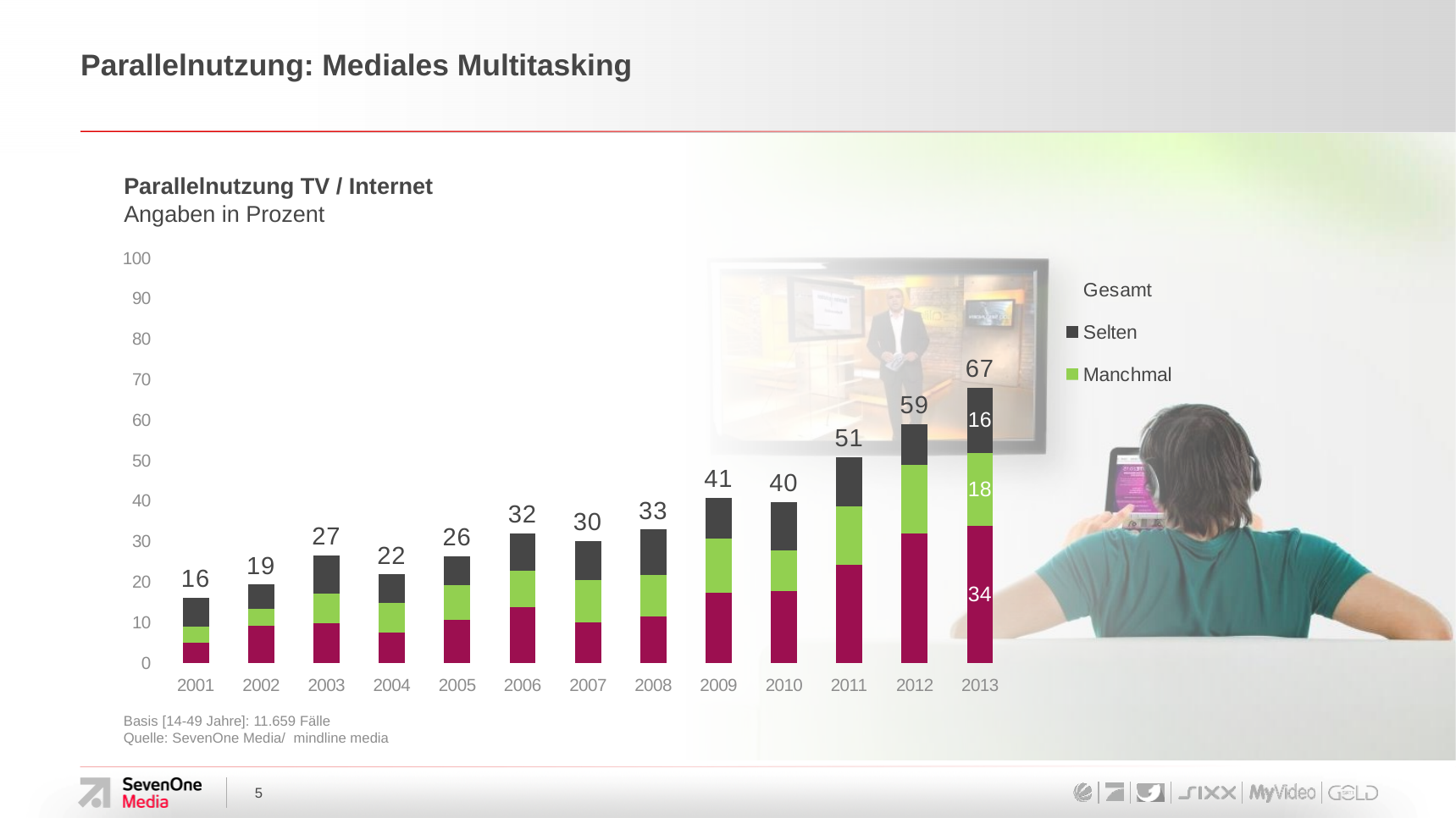
What is the value of the Manchmal segment in 2013? 18 What is the total value shown for 2001? 16 Do the total values generally rise or fall from 2001 to 2013? Rise Which year has the lowest total value? 2001 Which year has the highest total value? 2013 How many years are shown on the x axis? 13 What is the value of the Selten segment in 2013? 16 What is the total value shown for 2013? 67 What is the difference between the totals for 2013 and 2012? 8 Which year has the larger total, 2009 or 2010? 2009 Which year has the larger total, 2003 or 2004? 2003 What kind of chart is shown on the slide? Stacked bar chart